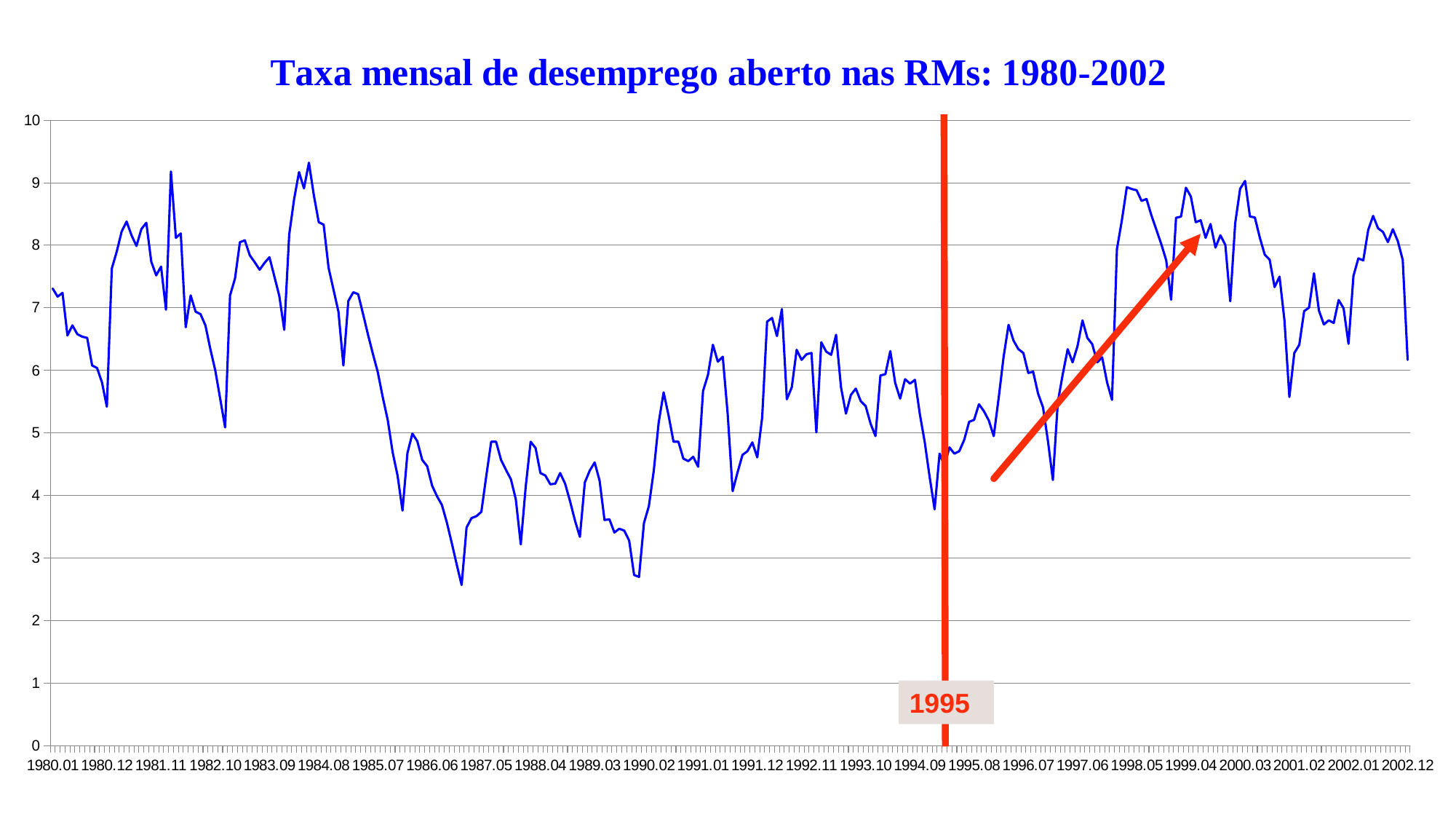
What kind of chart is shown on the slide? line chart How many data series (lines) are plotted on the chart? 1 Is the value at 1988.04 greater or less than 6? less Is the value at 1998.05 greater or less than 8? greater Is the value at 1980.01 greater or less than 5? greater Which is larger, the value at 1998.05 or the value at 1994.09? 1998.05 Which year is marked by the vertical red line on the chart? 1995 What is the title of the chart? Taxa mensal de desemprego aberto nas RMs: 1980-2002 Between 1995.08 and 1998.05, does the line generally rise or fall? rise Which is larger, the value at 1980.01 or the value at 2002.12? 1980.01